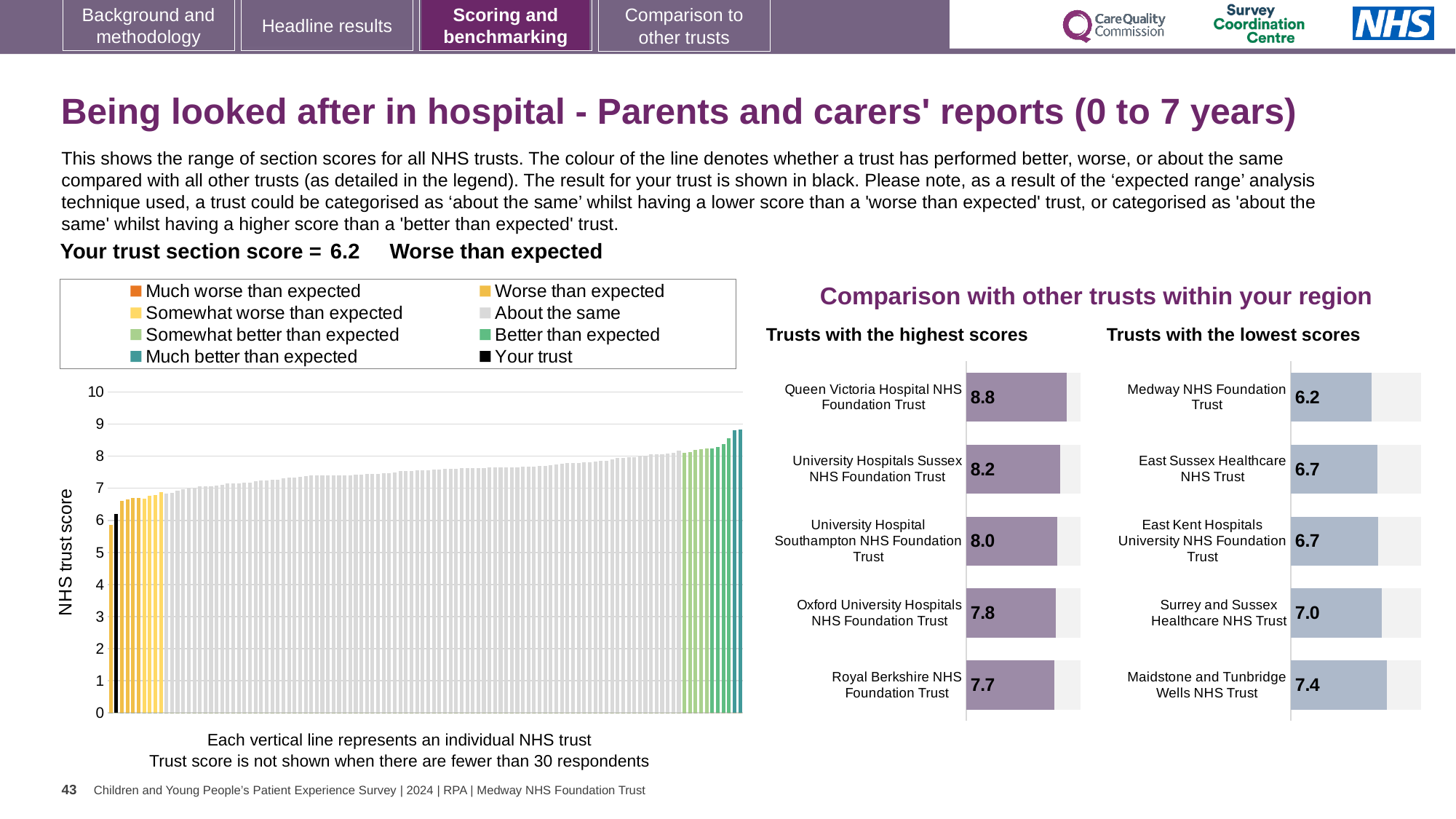
In the 'Trusts with the lowest scores' chart, what is the score for Surrey and Sussex Healthcare NHS Trust? 7.0 In the 'Trusts with the highest scores' chart, what is the difference between the scores of Queen Victoria Hospital NHS Foundation Trust and Royal Berkshire NHS Foundation Trust? 1.1 In the 'Trusts with the lowest scores' chart, what is the difference between the scores of Maidstone and Tunbridge Wells NHS Trust and Medway NHS Foundation Trust? 1.2 In the 'NHS trust score' chart on the left, do the values rise or fall from left to right? rise In the 'Trusts with the lowest scores' chart, which has the higher score: Maidstone and Tunbridge Wells NHS Trust or East Sussex Healthcare NHS Trust? Maidstone and Tunbridge Wells NHS Trust What kind of chart is the 'NHS trust score' chart on the left of the slide? bar chart In the 'NHS trust score' chart on the left, what colour is used for 'Your trust' according to the legend? black How many entries does the legend of the 'NHS trust score' chart on the left list? 8 In the 'Trusts with the highest scores' chart, which trust has the highest score? Queen Victoria Hospital NHS Foundation Trust In the 'Trusts with the highest scores' chart, what is the score for Queen Victoria Hospital NHS Foundation Trust? 8.8 In the 'Trusts with the lowest scores' chart, which trust has the lowest score? Medway NHS Foundation Trust How many trusts are shown in the 'Trusts with the highest scores' chart? 5